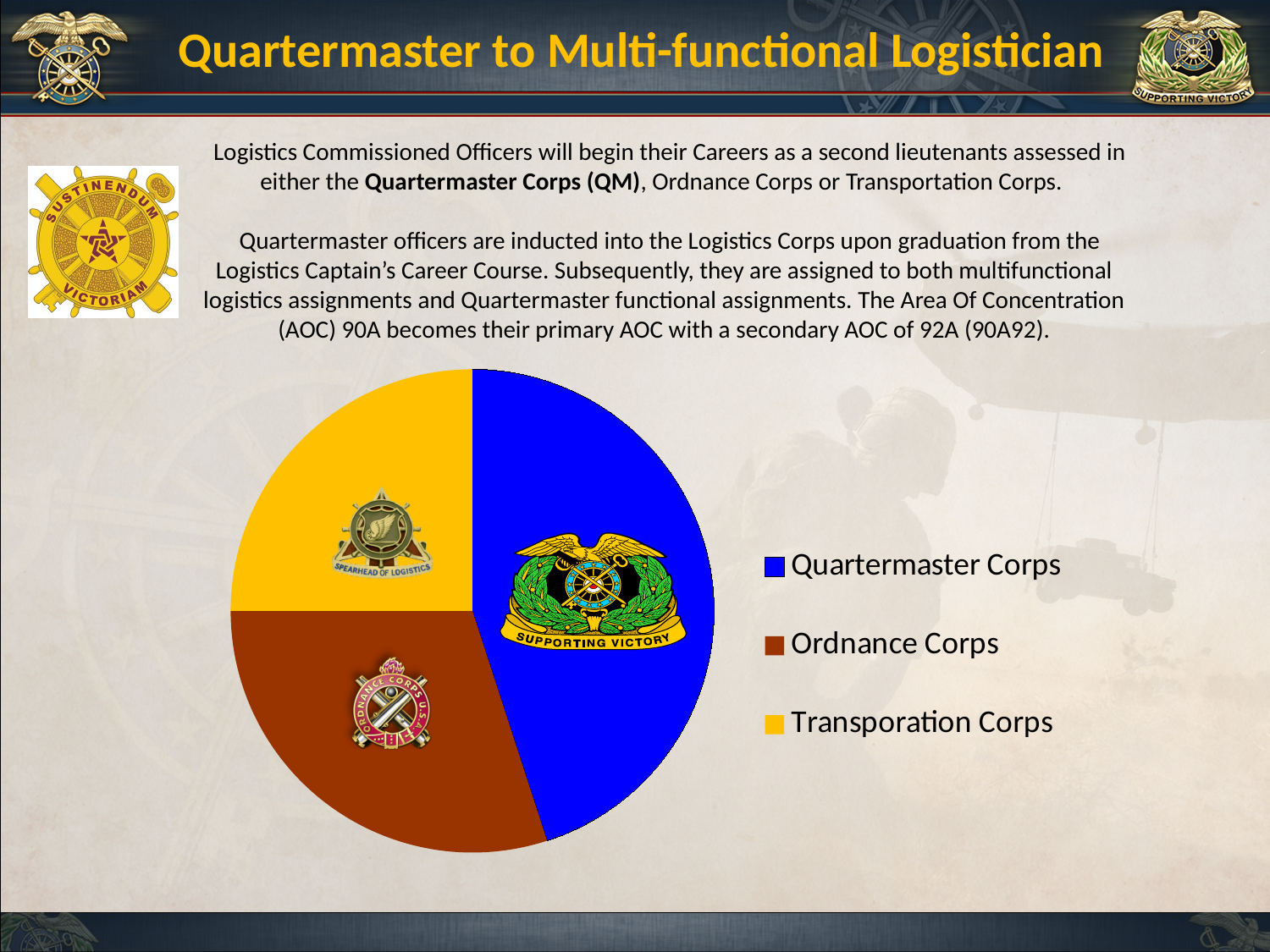
Which slice is larger in the pie chart, Quartermaster Corps or Transporation Corps? Quartermaster Corps How many entries does the legend of the pie chart list? 3 How many slices does the pie chart have? 3 What kind of chart is shown on the slide? Pie chart Which category in the pie chart is shown in yellow? Transporation Corps Which category has the largest slice in the pie chart? Quartermaster Corps Which slice is larger in the pie chart, Quartermaster Corps or Ordnance Corps? Quartermaster Corps What colour is the Quartermaster Corps slice in the pie chart? Blue